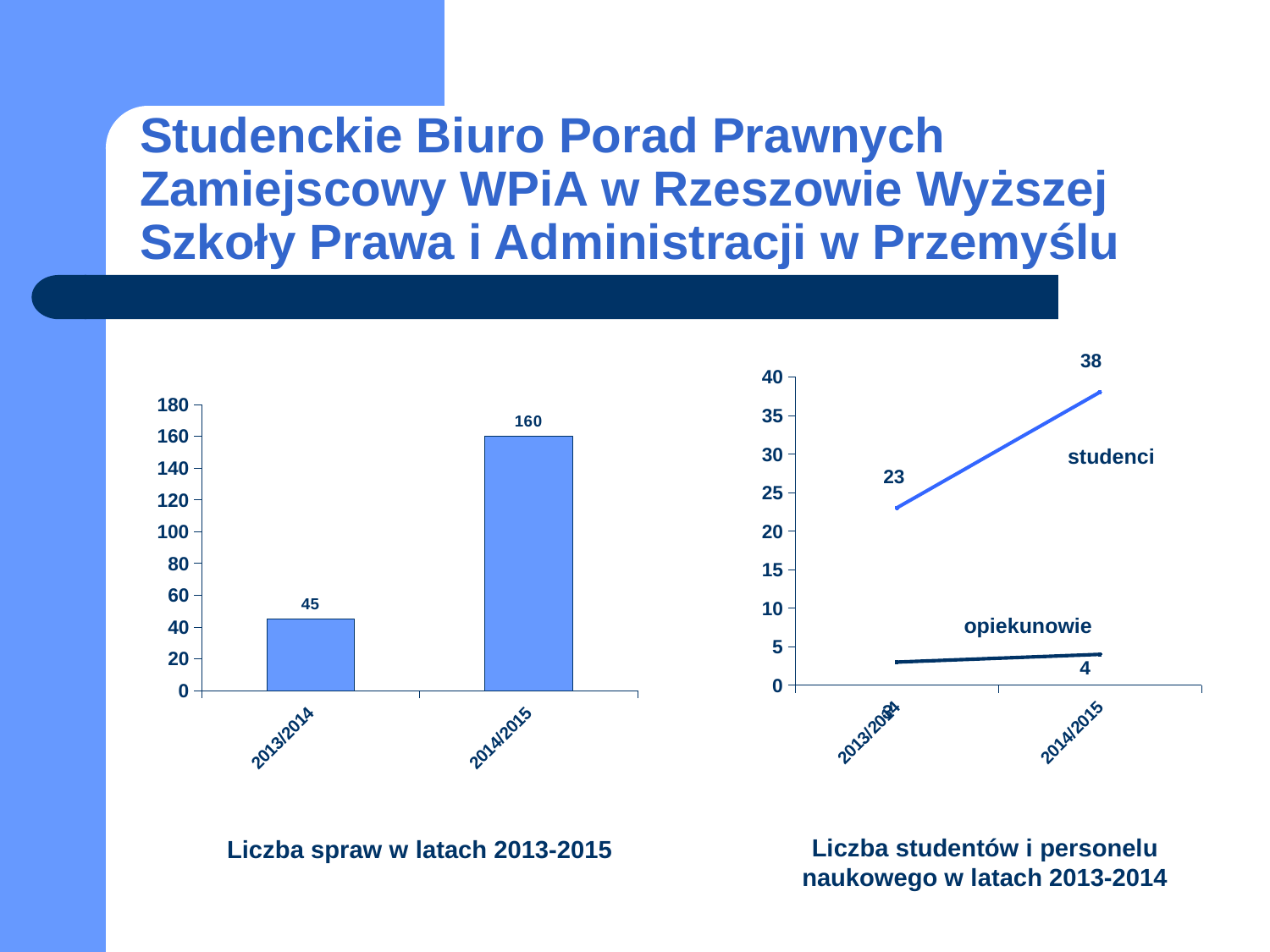
On the left chart (Liczba spraw w latach 2013-2015), what is the value for 2013/2014? 45 On the right chart (Liczba studentów i personelu naukowego), what is the value for studenci in 2013/2014? 23 On the right chart (Liczba studentów i personelu naukowego), what is the value for opiekunowie in 2014/2015? 4 On the left chart (Liczba spraw w latach 2013-2015), which year has the higher value? 2014/2015 What kind of chart is the left chart (Liczba spraw w latach 2013-2015)? bar chart On the right chart (Liczba studentów i personelu naukowego), is the value for opiekunowie in 2013/2014 greater or less than 5? less What kind of chart is the right chart (Liczba studentów i personelu naukowego)? line chart On the left chart (Liczba spraw w latach 2013-2015), how many bars are plotted? 2 On the right chart (Liczba studentów i personelu naukowego), by how much did the studenci value increase from 2013/2014 to 2014/2015? 15 On the right chart (Liczba studentów i personelu naukowego), what is the value for studenci in 2014/2015? 38 On the left chart (Liczba spraw w latach 2013-2015), what is the difference between the 2014/2015 and 2013/2014 values? 115 On the left chart (Liczba spraw w latach 2013-2015), what is the value for 2014/2015? 160